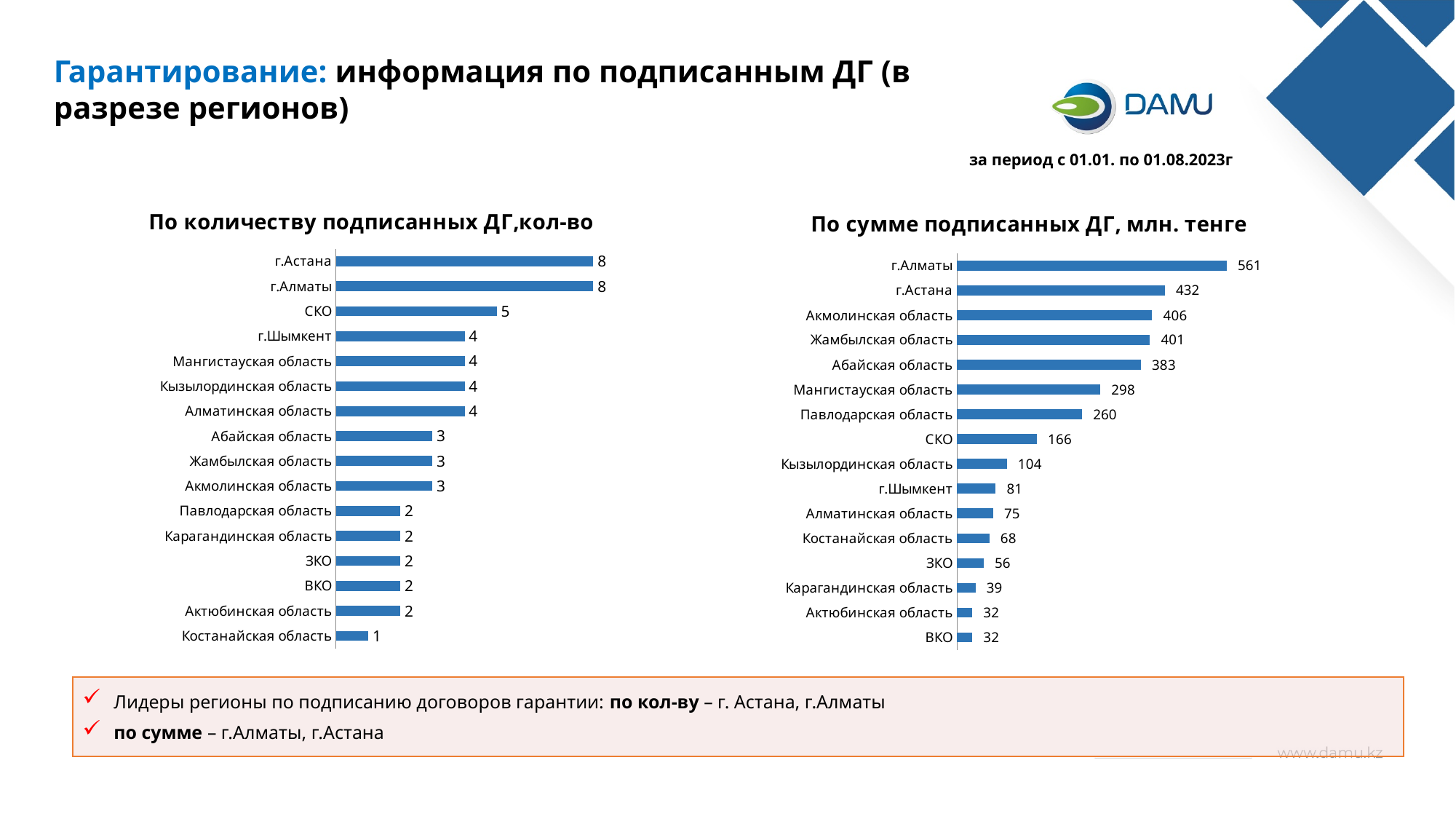
How many regions are shown in the chart 'По количеству подписанных ДГ,кол-во'? 16 In the chart 'По сумме подписанных ДГ, млн. тенге', which region has the highest value? г.Алматы In the chart 'По количеству подписанных ДГ,кол-во', what is the value for СКО? 5 How many regions are shown in the chart 'По сумме подписанных ДГ, млн. тенге'? 16 What type of chart is 'По сумме подписанных ДГ, млн. тенге'? Bar chart In the chart 'По сумме подписанных ДГ, млн. тенге', what is the value for Кызылординская область? 104 In the chart 'По количеству подписанных ДГ,кол-во', what is the difference between г.Астана and СКО? 3 In the chart 'По сумме подписанных ДГ, млн. тенге', what is the difference between г.Алматы and г.Астана? 129 In the chart 'По сумме подписанных ДГ, млн. тенге', which is larger: Мангистауская область or СКО? Мангистауская область In the chart 'По сумме подписанных ДГ, млн. тенге', what is the value for Павлодарская область? 260 In the chart 'По количеству подписанных ДГ,кол-во', which region has the lowest value? Костанайская область What period is stated on the slide for the data? с 01.01. по 01.08.2023г